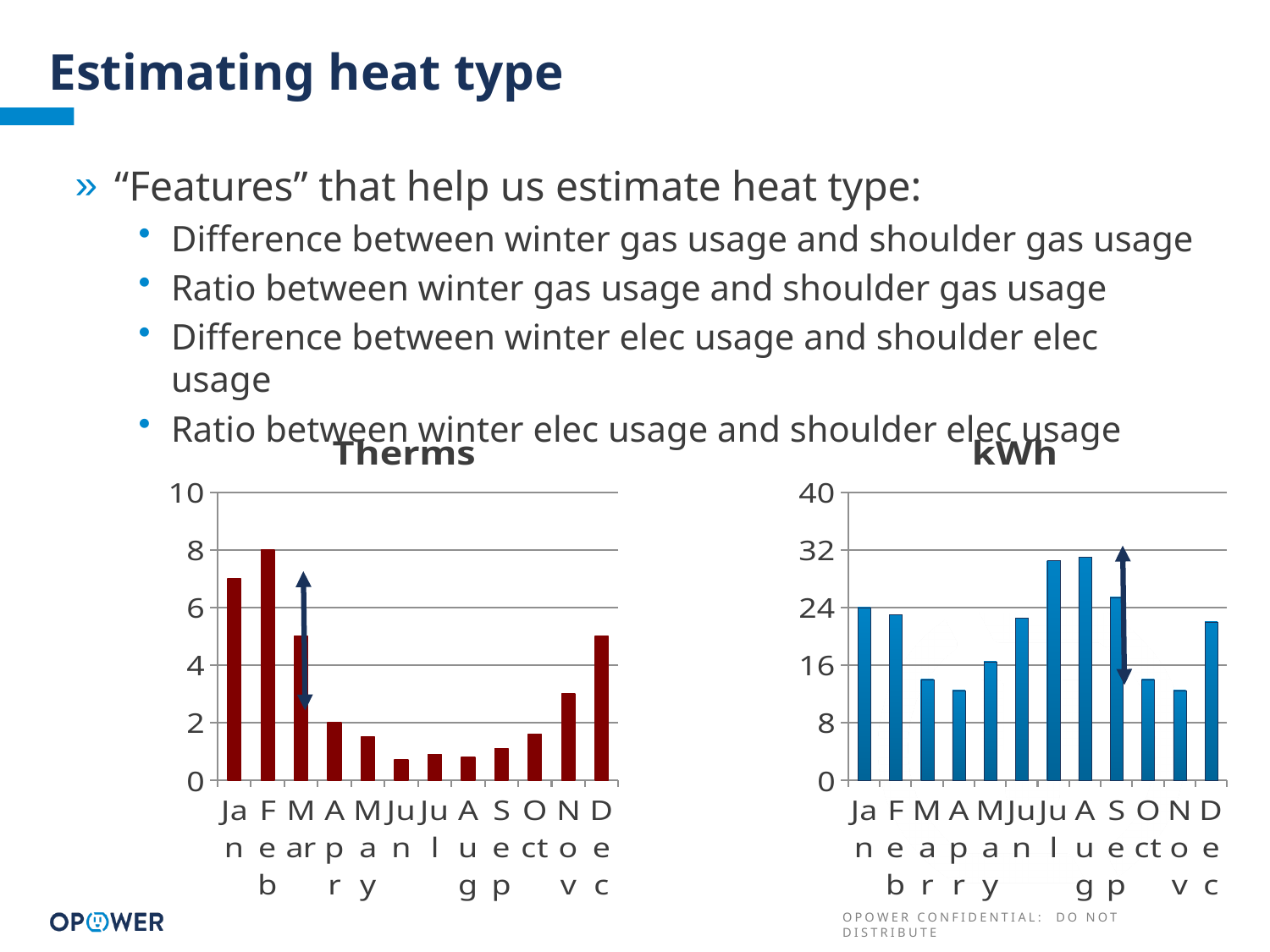
On the Therms chart, what is the value for Apr? 2 On the Therms chart, which month has the highest value? Feb How many months are plotted on the kWh chart? 12 On the Therms chart, which is larger, the value for Feb or the value for Dec? Feb On the kWh chart, what is the value for Jan? 24 On the Therms chart, is the value for Jan greater or less than 6? greater On the kWh chart, which is larger, the value for Jul or the value for Mar? Jul What kind of chart is the Therms chart? bar chart On the Therms chart, what is the value for Feb? 8 On the kWh chart, is the value for Jul greater or less than 24? greater What is the title of the chart on the right side of the slide? kWh On the kWh chart, is the value for Mar greater or less than 16? less